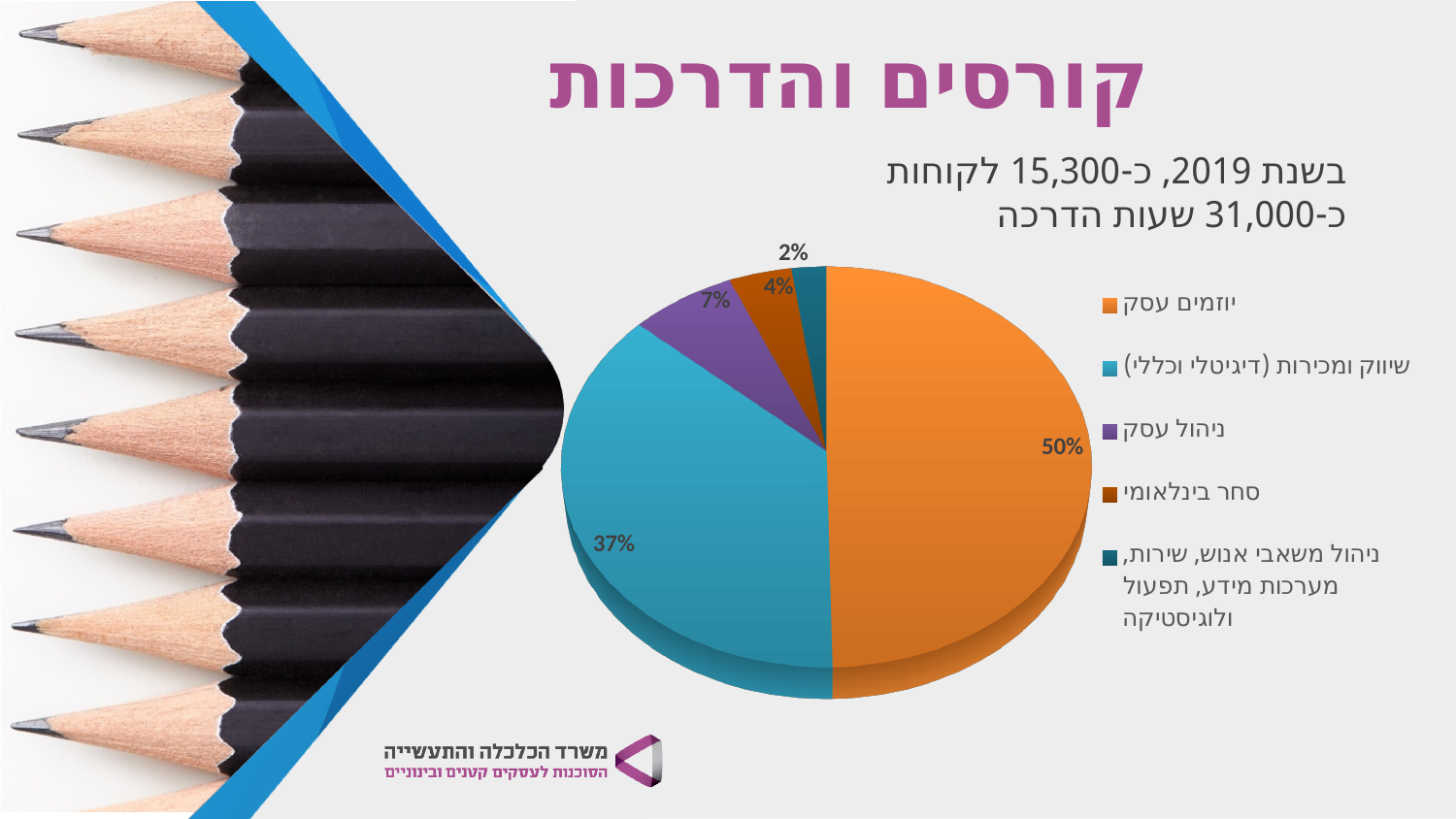
What share of the pie does סחר בינלאומי have? 4% Which category has the largest slice of the pie? יוזמים עסק What share of the pie does ניהול משאבי אנוש, שירות, מערכות מידע, תפעול ולוגיסטיקה have? 2% What is the difference in percentage points between יוזמים עסק and שיווק ומכירות (דיגיטלי וכללי)? 13% How many categories does the pie chart have? 5 What share of the pie does שיווק ומכירות (דיגיטלי וכללי) have? 37% Which category has the smallest slice of the pie? ניהול משאבי אנוש, שירות, מערכות מידע, תפעול ולוגיסטיקה What is the title of the slide containing the pie chart? קורסים והדרכות Which is larger, the slice for ניהול עסק or the slice for סחר בינלאומי? ניהול עסק What kind of chart is shown on the slide? Pie chart